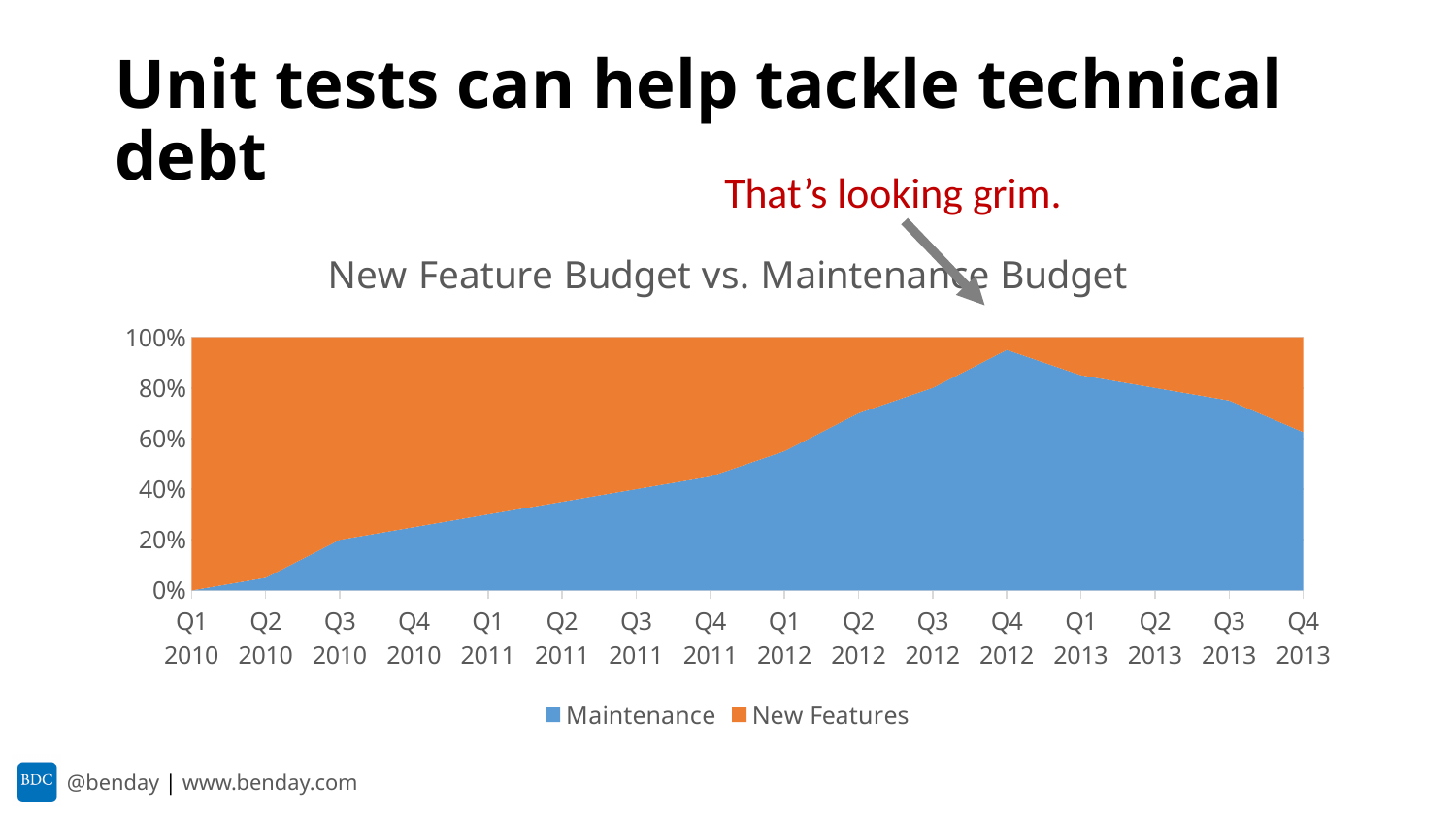
Is the Maintenance share in Q4 2012 greater or less than 80%? greater What is the title of the chart? New Feature Budget vs. Maintenance Budget Which is larger, the Maintenance share in Q4 2012 or in Q4 2013? Q4 2012 What kind of chart is shown on the slide? Area chart How many quarters are shown along the x axis? 16 How many series does the legend list? 2 Is the Maintenance share in Q1 2011 greater or less than 40%? less Which colour represents the New Features series? Orange Does the Maintenance share rise or fall from Q1 2010 to Q4 2012? Rise Is the Maintenance share in Q2 2012 greater or less than 60%? greater In which quarter does the Maintenance share reach its highest point? Q4 2012 In which quarter is the Maintenance share at its lowest? Q1 2010